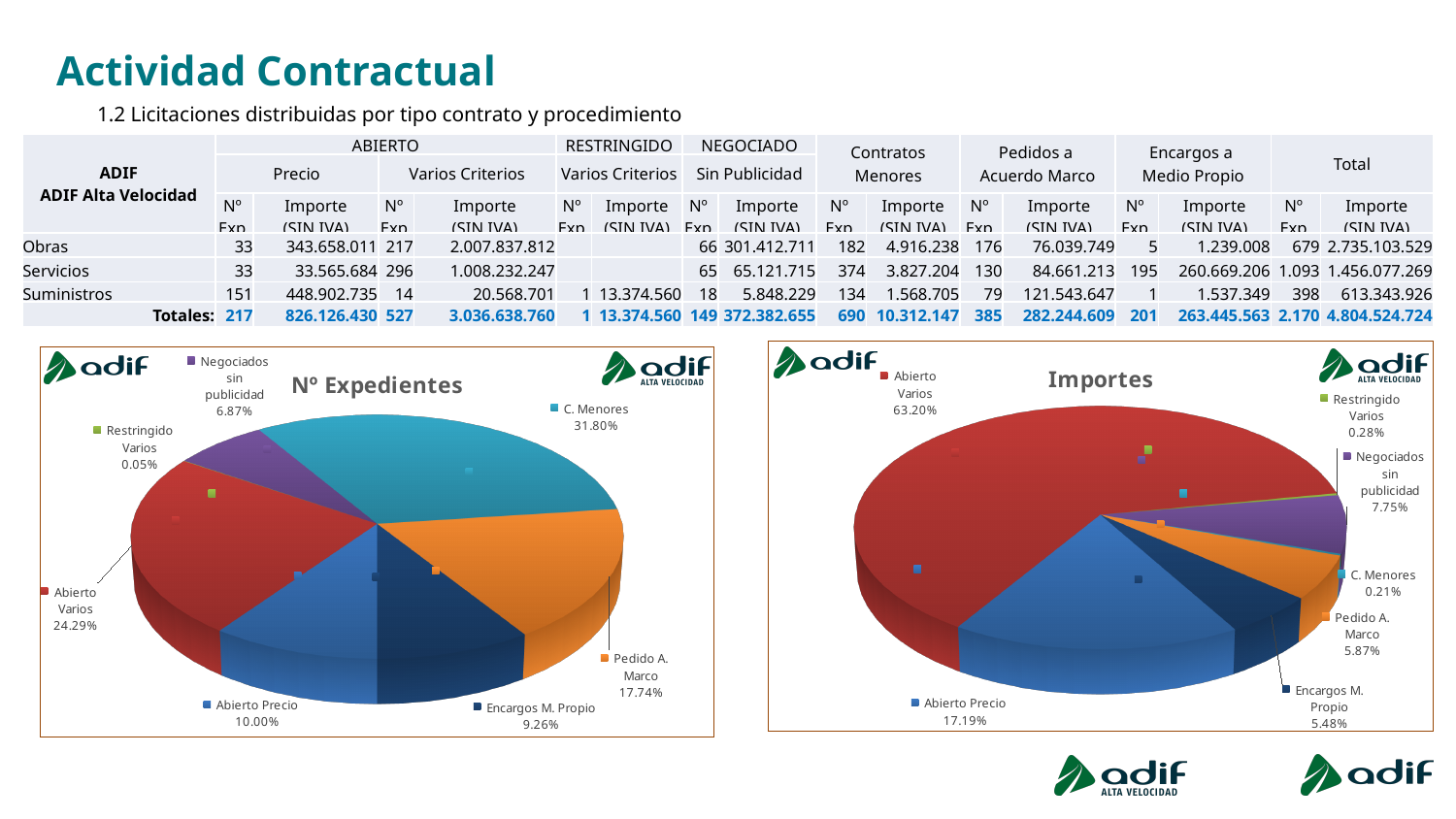
In the "Nº Expedientes" chart, what is the difference between the shares of Pedido A. Marco and Abierto Precio? 7.74% In the "Importes" chart, what share does Abierto Varios have? 63.20% In the "Nº Expedientes" chart, which category has the smallest share? Restringido Varios In the "Importes" chart, which is larger, Pedido A. Marco or Encargos M. Propio? Pedido A. Marco In the "Nº Expedientes" chart, which category has the largest share? C. Menores In the "Importes" chart, which category has the largest share? Abierto Varios In the "Nº Expedientes" chart, how many slices are there? 7 What type of chart is the "Importes" chart? Pie chart In the "Nº Expedientes" chart, what share does Abierto Varios have? 24.29% In the "Importes" chart, what is the difference between the shares of Negociados sin publicidad and Restringido Varios? 7.47% In the "Importes" chart, what share does Abierto Precio have? 17.19%